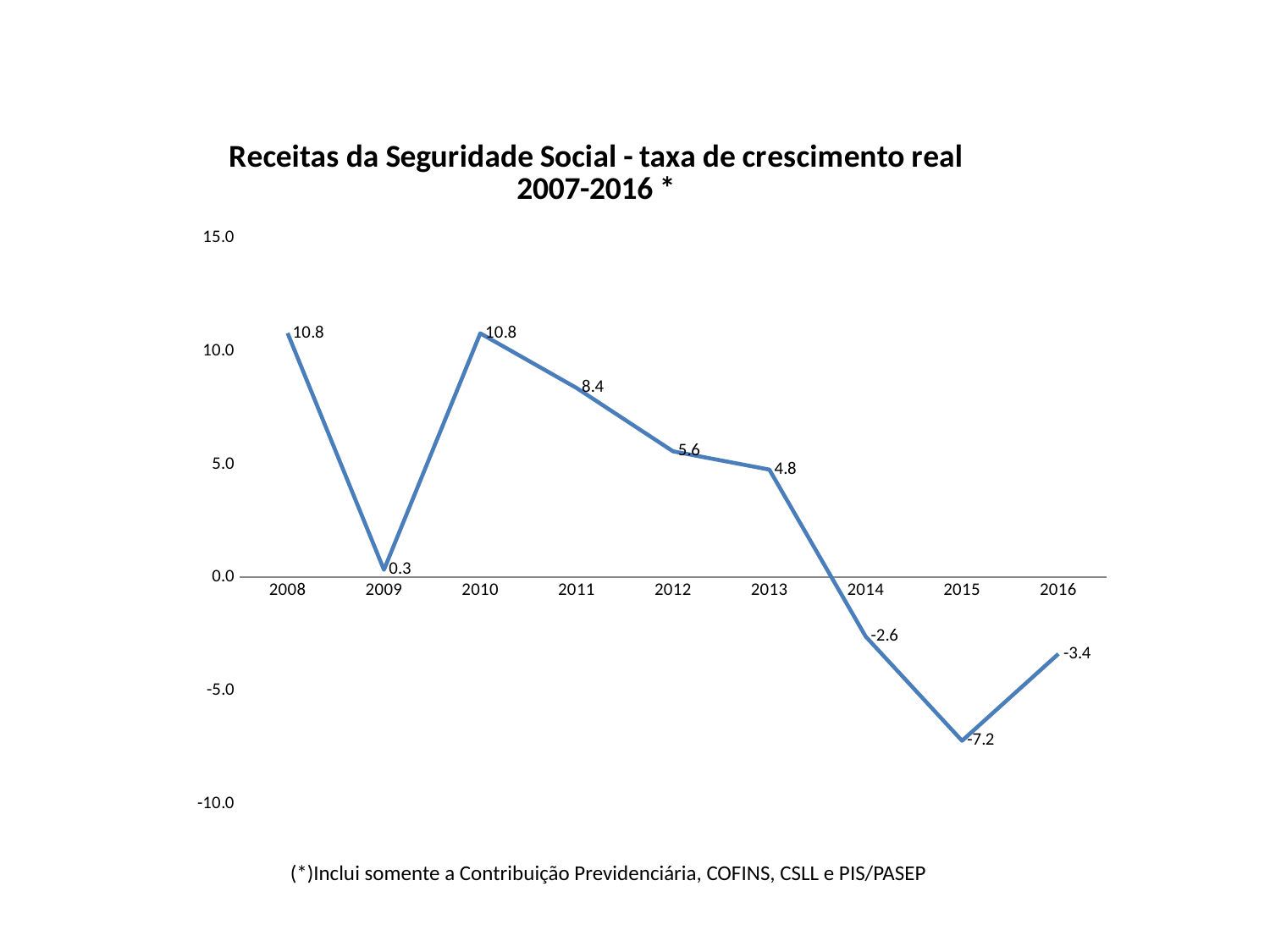
What is the value for 2011? 8.4 Is the value for 2013 greater or less than 5.0? less What kind of chart is shown? line chart Do the values rise or fall from 2010 to 2015? fall What is the difference between the values for 2010 and 2013? 6.0 What is the value for 2009? 0.3 What is the value for 2015? -7.2 What is the title of the chart? Receitas da Seguridade Social - taxa de crescimento real 2007-2016 * What is the difference between the values for 2014 and 2016? 0.8 How many years are plotted on the x axis? 9 Which year has the lowest value? 2015 Which is larger, the value for 2012 or the value for 2014? 2012